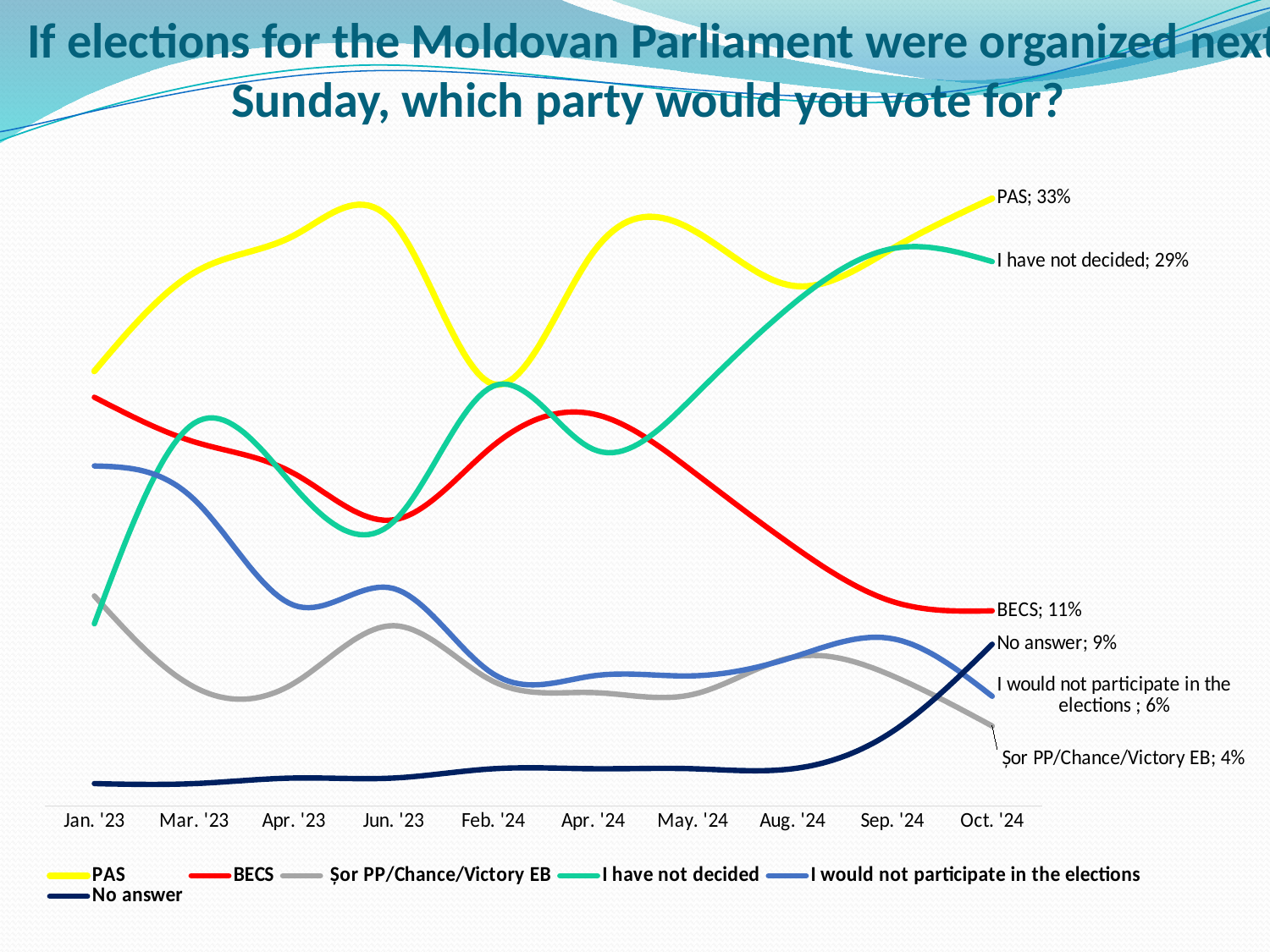
What kind of chart is shown on the slide? line chart What is the value for Șor PP/Chance/Victory EB in Oct. '24? 4% Which series has the lowest value in Oct. '24? Șor PP/Chance/Victory EB What is the value for BECS in Oct. '24? 11% What is the difference between the PAS and BECS values in Oct. '24? 22% Does the BECS line rise or fall between Apr. '24 and Oct. '24? fall What is the value for 'I have not decided' in Oct. '24? 29% Which series has the highest value in Oct. '24? PAS What is the value for PAS in Oct. '24? 33% How many series does the legend list? 6 What is the value for 'No answer' in Oct. '24? 9% How many time points are shown on the x axis? 10